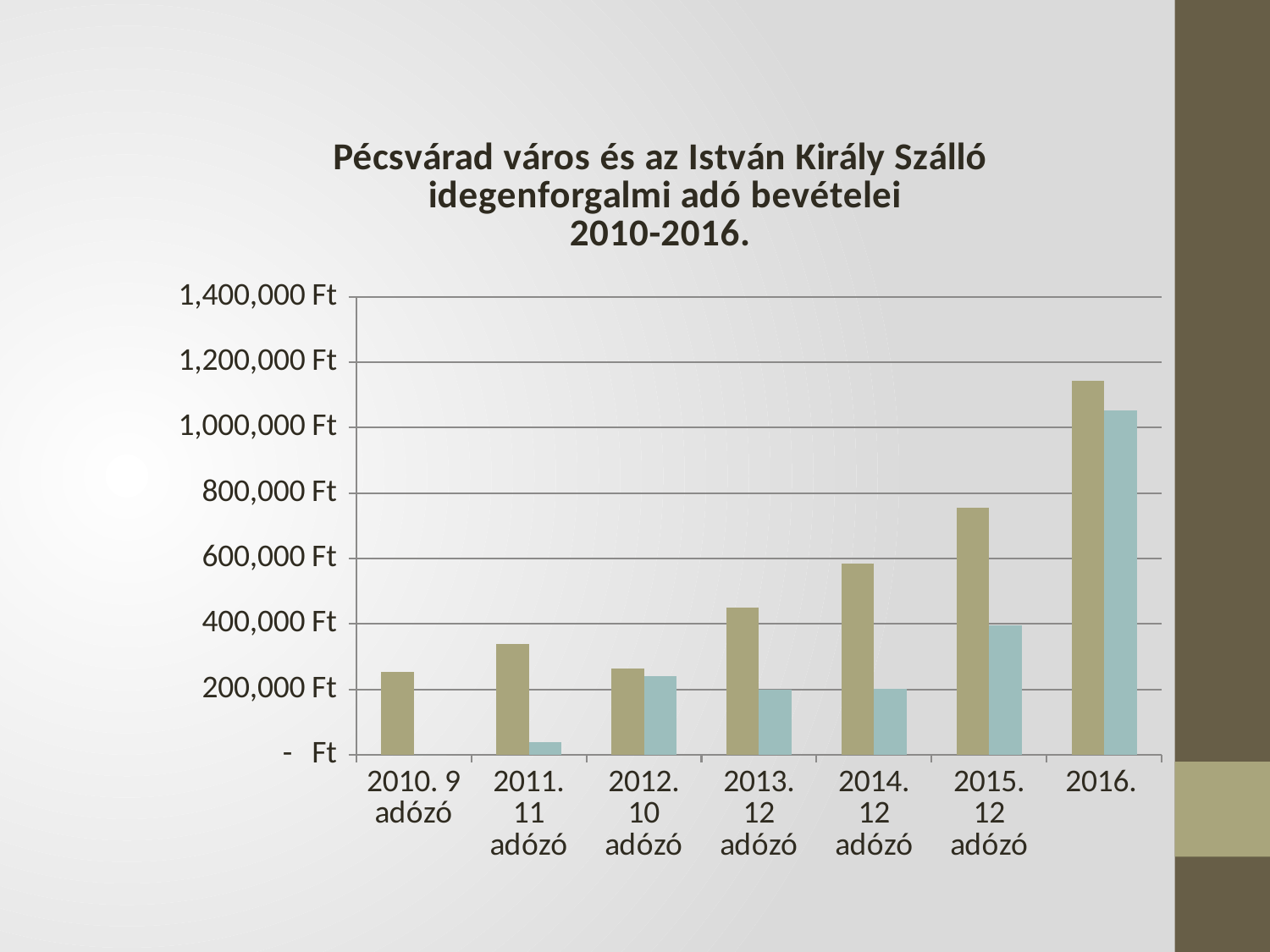
Is the tan (left) bar for 2016. greater or less than 1,000,000 Ft? greater Which is taller, the tan bar for 2013. 12 adózó or the tan bar for 2011. 11 adózó? 2013. 12 adózó In 2016., which bar is taller, the tan (left) one or the teal (right) one? the tan (left) one Do the tan (left) bars rise or fall from 2013. to 2016.? rise Is the teal (right) bar for 2015. 12 adózó greater or less than 200,000 Ft? greater Is the teal (right) bar for 2011. 11 adózó greater or less than 200,000 Ft? less What kind of chart is shown on the slide? bar chart Which year has the tallest tan (left) bar? 2016. What unit is shown on the vertical axis labels? Ft How many year categories are shown on the x axis? 7